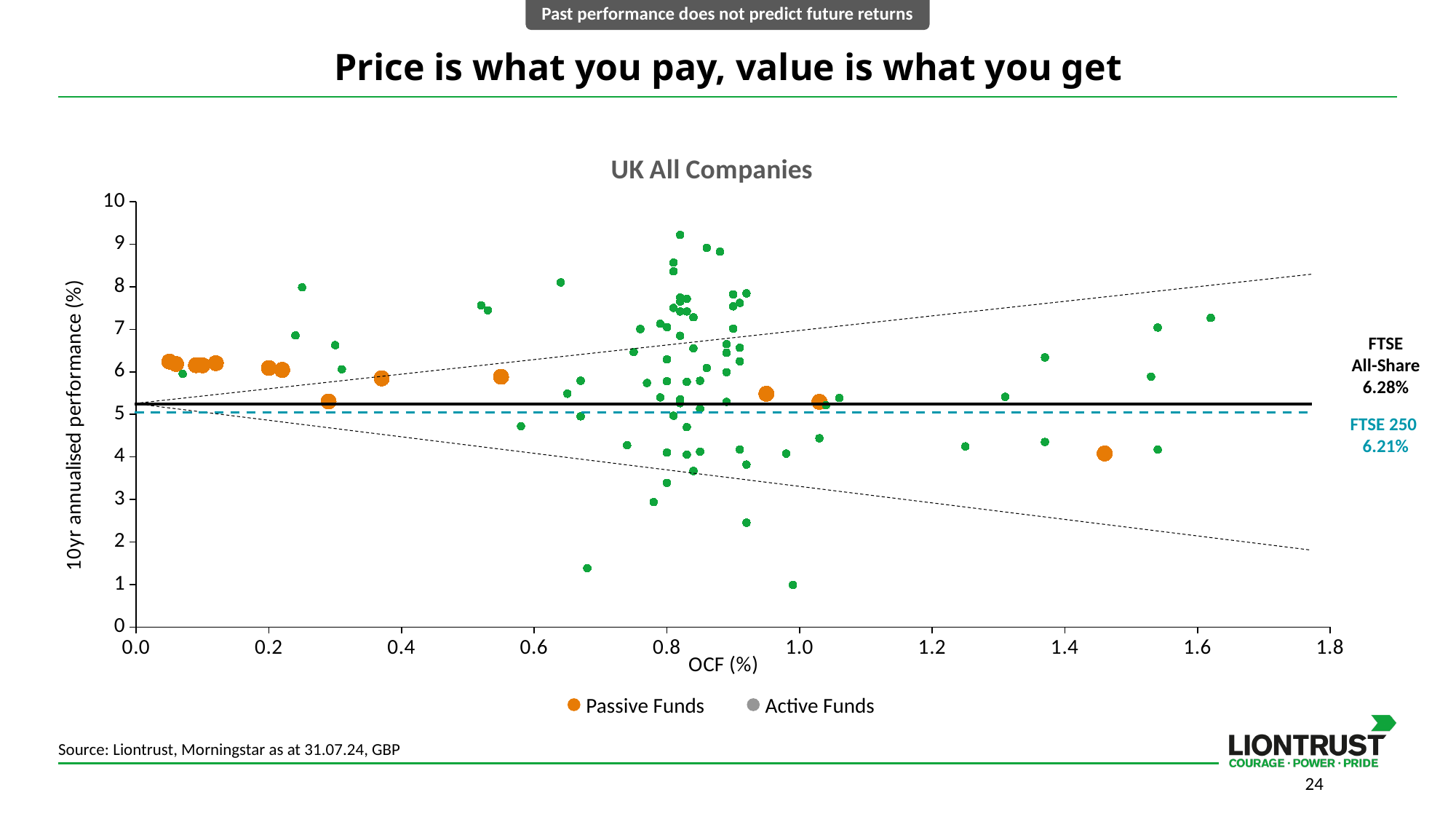
What 10yr annualised performance is shown for the FTSE All-Share? 6.28% What kind of chart is shown on the slide? Scatter chart Is the Passive Funds point with the highest OCF (around 1.46%) greater or less than 5 on the y axis? less Which has the higher value shown, the FTSE All-Share or the FTSE 250? FTSE All-Share What is the difference between the FTSE All-Share value and the FTSE 250 value? 0.07% Is the highest Active Funds point on the chart greater or less than 9 on the y axis? greater How many series does the legend list? 2 What is the title of the chart? UK All Companies Is the lowest Active Funds point on the chart greater or less than 2 on the y axis? less What 10yr annualised performance is shown for the FTSE 250? 6.21% What is the highest value shown on the x axis (OCF)? 1.8 What are the two series named in the legend? Passive Funds and Active Funds